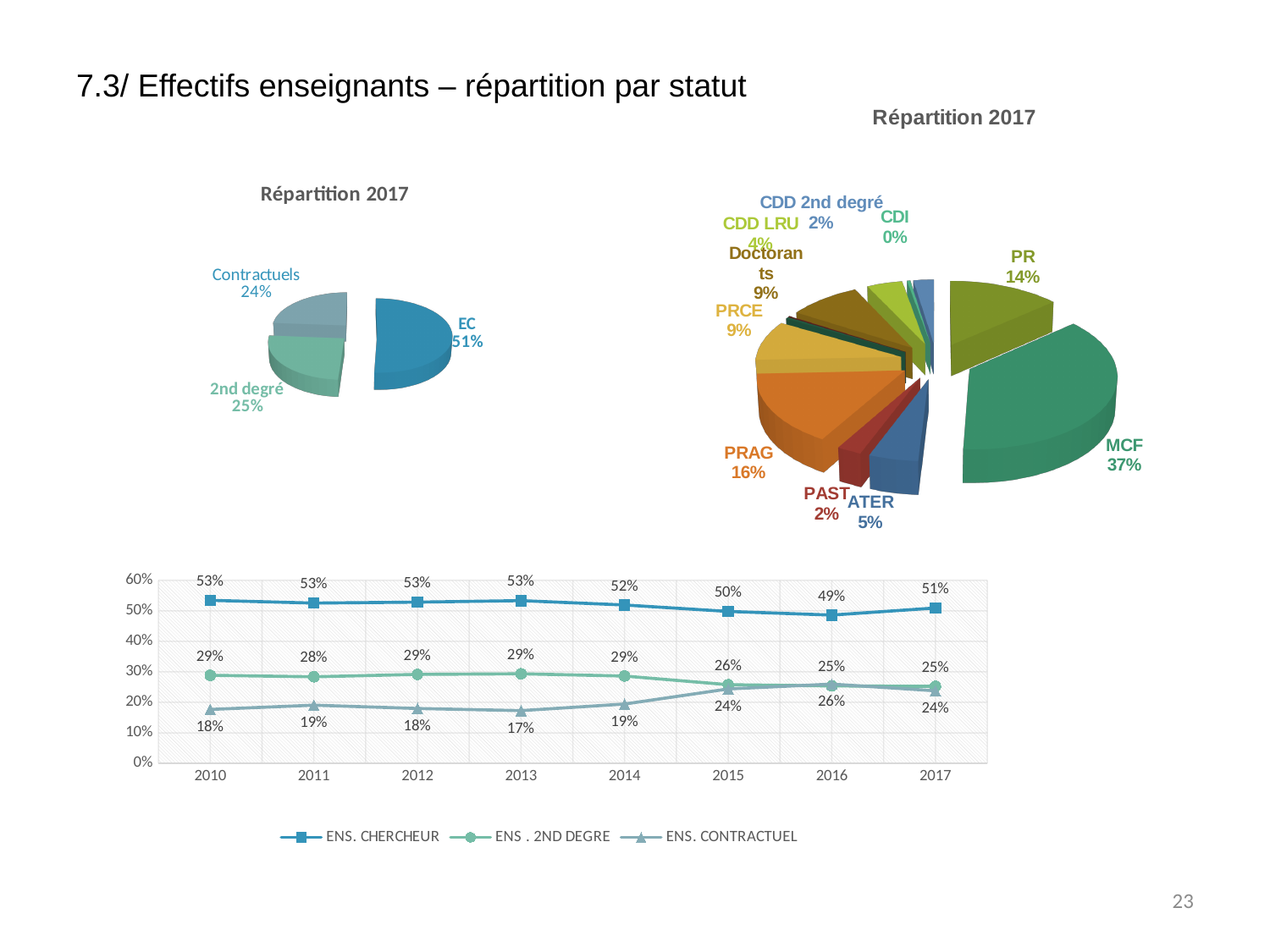
In the right pie chart, what is the share for PRAG? 16% In the bottom line chart, how many series does the legend list? 3 In the bottom line chart, what is the value for ENS. CHERCHEUR in 2016? 49% In the bottom line chart, what is the value for ENS. CONTRACTUEL in 2013? 17% In the right pie chart, which is larger, the share of PRCE or the share of ATER? PRCE In the right pie chart, what is the share for MCF? 37% In the bottom line chart, does the ENS. CONTRACTUEL series generally rise or fall from 2010 to 2017? rise In the bottom line chart, how many years are shown on the x axis? 8 In the left pie chart, what share does EC have? 51% In the right pie chart, what is the difference between the shares of MCF and PR? 23% In the left pie chart, which category has the smallest share? Contractuels In the right pie chart, which category has the largest share? MCF